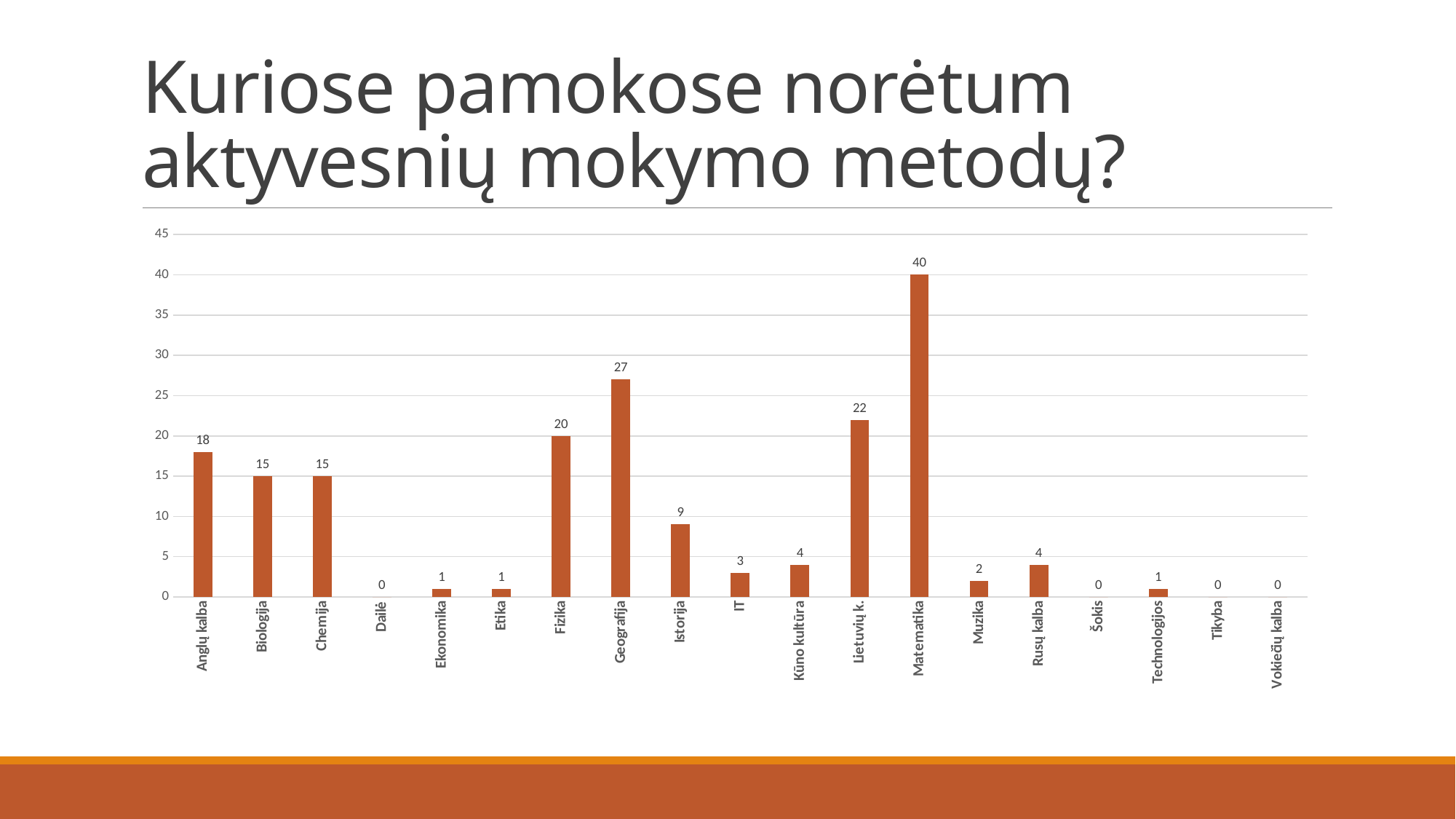
How many categories are shown on the x axis? 19 What is the value for Matematika? 40 What is the value for Geografija? 27 What is the value for Kūno kultūra? 4 What is the title of the slide? Kuriose pamokose norėtum aktyvesnių mokymo metodų? What is the value for Istorija? 9 Which category has the highest value? Matematika Is the value for Fizika greater or less than 15? greater What is the difference between the values for Lietuvių k. and Fizika? 2 What is the difference between the values for Matematika and Geografija? 13 What kind of chart is shown on the slide? Bar chart Which is larger, the value for Anglų kalba or the value for Biologija? Anglų kalba